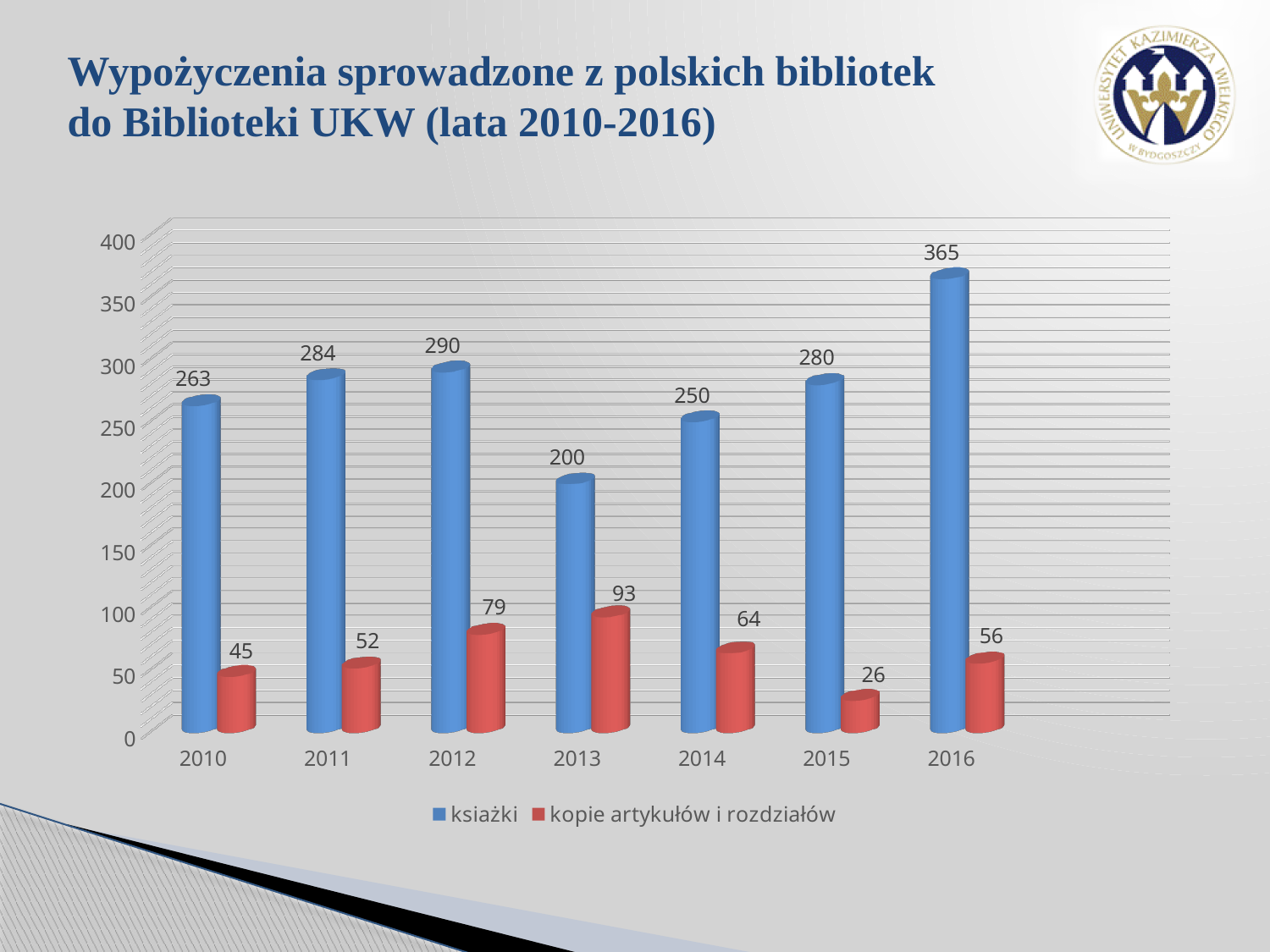
How many years are shown on the x axis? 7 What kind of chart is shown on the slide? bar chart What is the difference between the ksiażki values for 2016 and 2013? 165 What is the total of ksiażki and kopie artykułów i rozdziałów for 2010? 308 What is the value for kopie artykułów i rozdziałów in 2013? 93 What is the value for ksiażki in 2016? 365 Is the value for ksiażki in 2015 greater or less than 250? greater Which year has the lowest value for kopie artykułów i rozdziałów? 2015 Which year has the highest value for ksiażki? 2016 What is the value for ksiażki in 2013? 200 How many series does the legend list? 2 Which is larger: kopie artykułów i rozdziałów in 2012 or in 2014? 2012